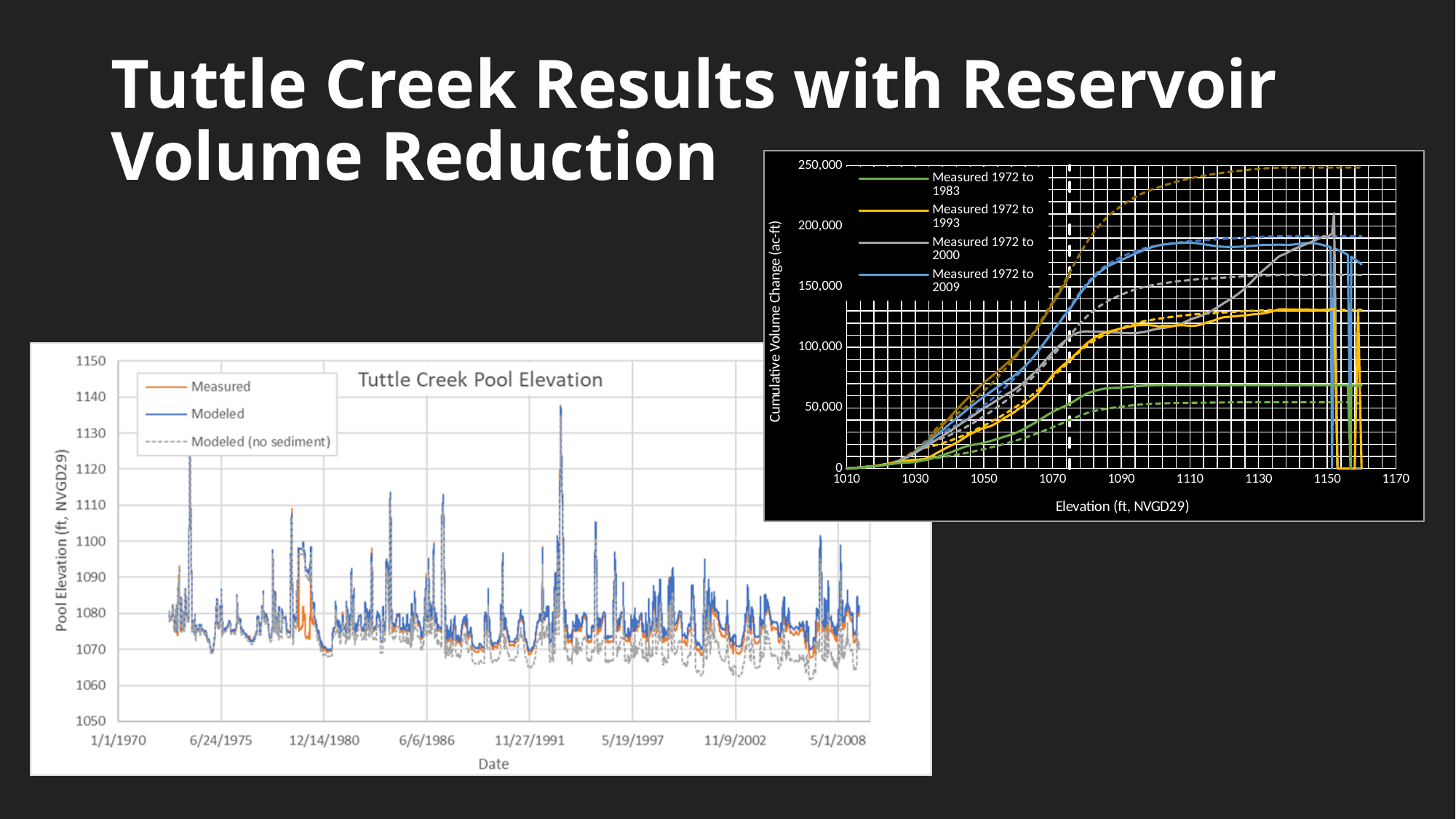
In the cumulative volume change chart on the right, do the series generally rise or fall as elevation increases from 1010 to 1150? rise How many series does the legend of the cumulative volume change chart on the right list? 4 In the cumulative volume change chart on the right, what is the label of the x axis? Elevation (ft, NVGD29) What type of chart is the Tuttle Creek Pool Elevation chart? line chart In the cumulative volume change chart on the right, which legend series reaches the lowest cumulative volume change? Measured 1972 to 1983 In the Tuttle Creek Pool Elevation chart, what is the label of the y axis? Pool Elevation (ft, NVGD29) How many series does the legend of the Tuttle Creek Pool Elevation chart list? 3 In the cumulative volume change chart on the right, is the plateau value of the Measured 1972 to 1983 series greater or less than 100,000? less In the cumulative volume change chart on the right, is the plateau value of the Measured 1972 to 1993 series greater or less than 100,000? greater In the Tuttle Creek Pool Elevation chart, which series is drawn as a dashed line? Modeled (no sediment) What type of chart is the cumulative volume change chart on the right? line chart In the cumulative volume change chart on the right, is the plateau value of the Measured 1972 to 2009 series greater or less than 150,000? greater